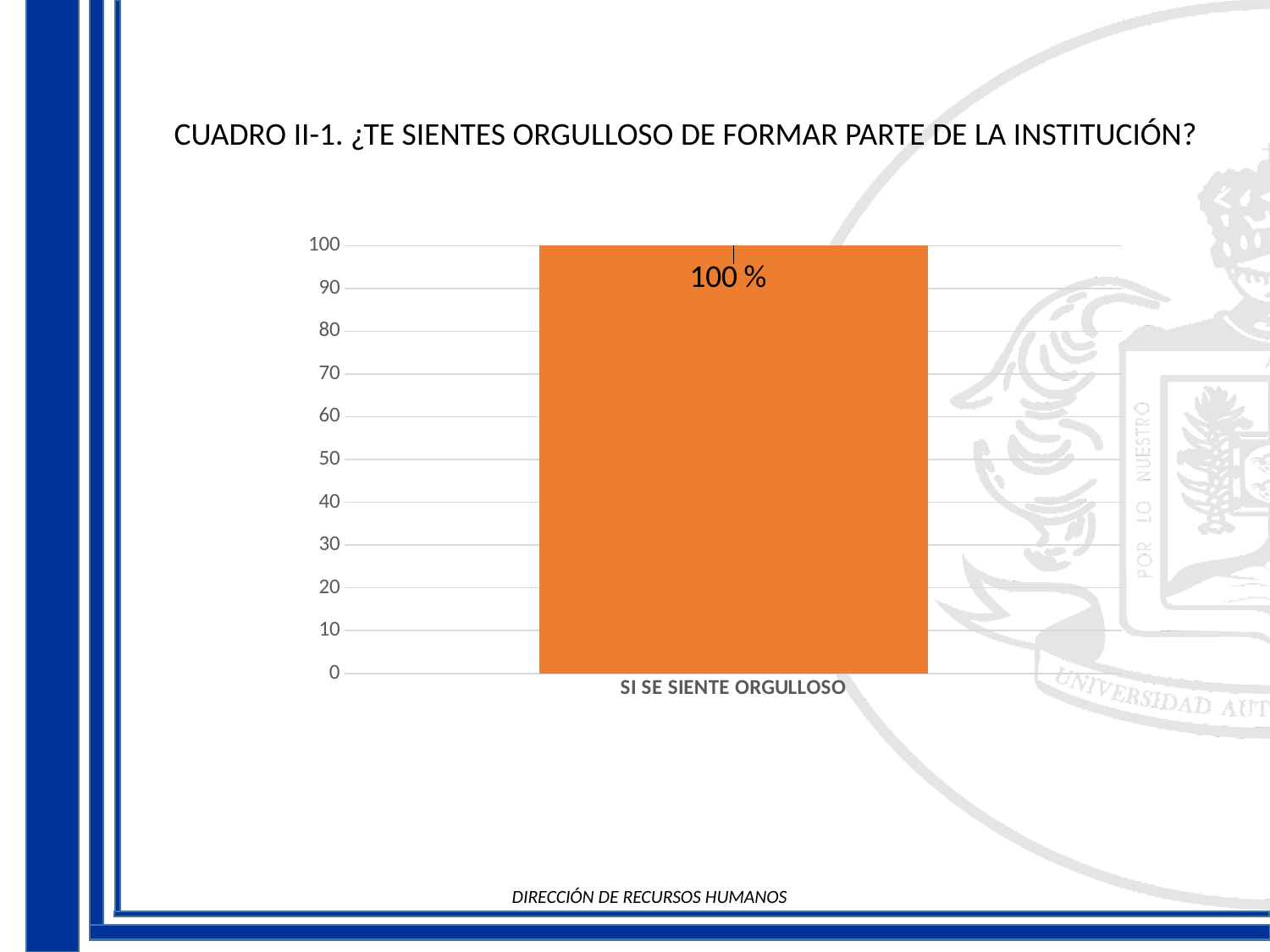
What kind of chart is shown on the slide? bar chart Is the value for SI SE SIENTE ORGULLOSO greater or less than 50? greater What colour is the bar in the chart? orange What is the label of the single category on the x axis? SI SE SIENTE ORGULLOSO What is the value shown for SI SE SIENTE ORGULLOSO? 100 % What is the highest value shown on the vertical axis? 100 How many categories are plotted on the x axis? 1